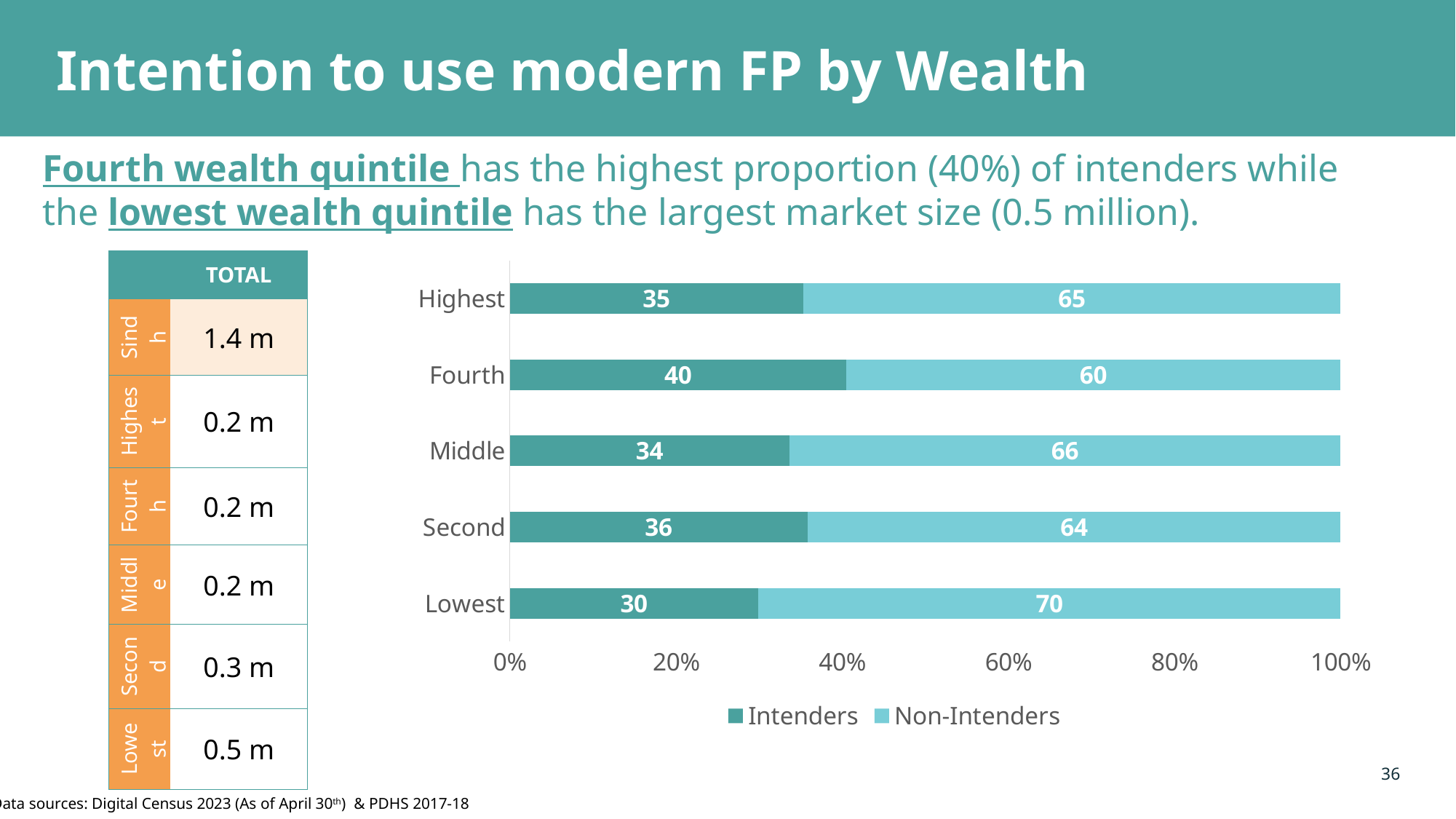
What is the Non-Intenders value for the Lowest wealth quintile? 70 Which is larger, the Intenders value for Highest or for Second? Second What kind of chart is shown on the slide? Stacked bar chart Is the Intenders value for the Fourth quintile greater or less than 20%? greater Which wealth quintile has the highest Intenders value? Fourth How many series does the legend list? 2 What is the total of the stacked bar for the Second quintile? 100 What is the Intenders value for the Fourth wealth quintile? 40 What is the difference between the Intenders values for the Fourth and Lowest quintiles? 10 What is the Intenders value for the Middle wealth quintile? 34 Which wealth quintile has the lowest Intenders value? Lowest How many wealth quintile categories are shown in the chart? 5